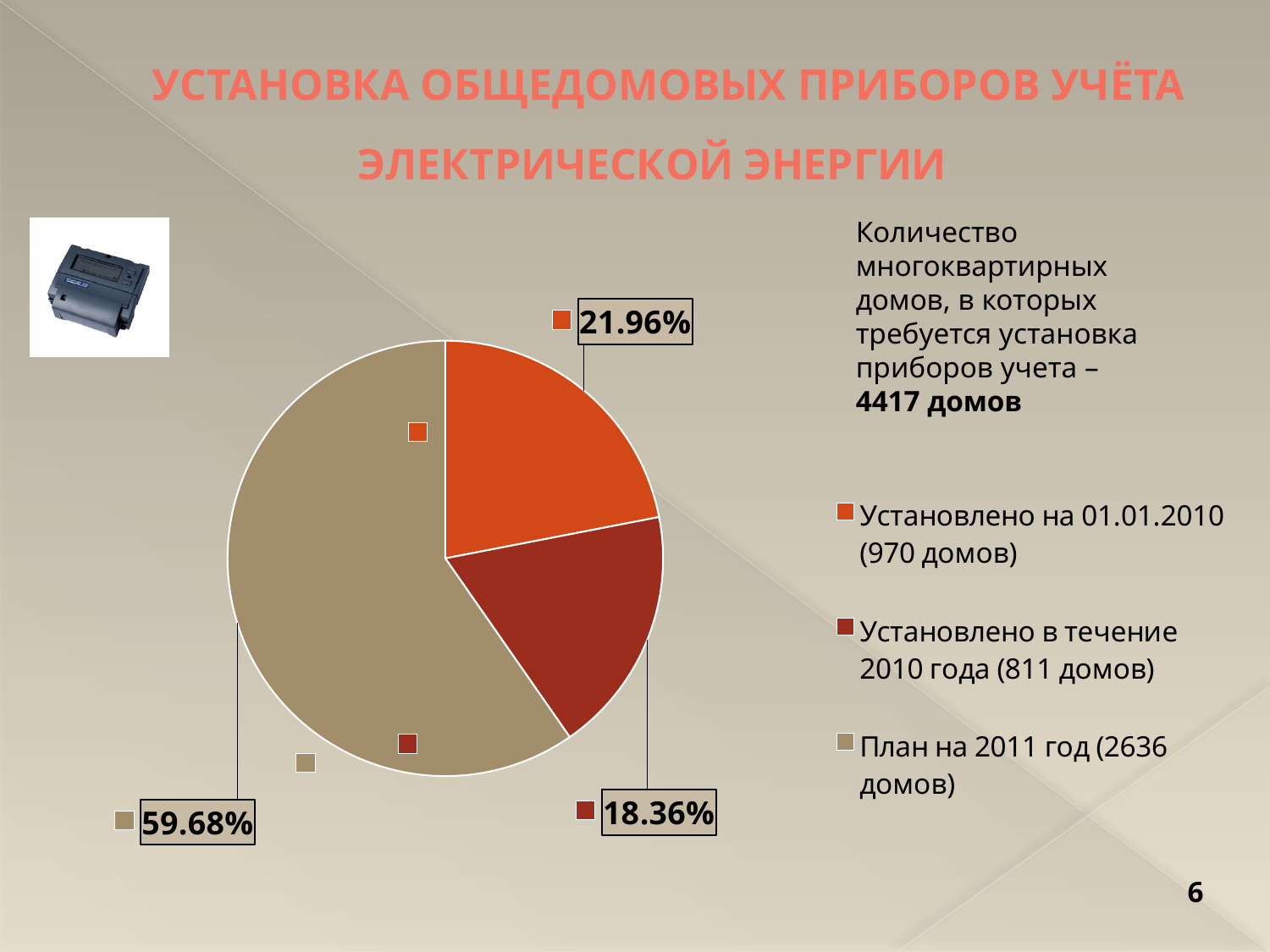
What percentage share does the slice 'Установлено на 01.01.2010' have in the pie chart? 21.96% What is the difference in percentage points between the 'План на 2011 год' slice and the 'Установлено на 01.01.2010' slice? 37.72 How many houses does the legend give for 'План на 2011 год'? 2636 домов Which slice of the pie chart is the smallest? Установлено в течение 2010 года Which slice of the pie chart is the largest? План на 2011 год What percentage share does the slice 'План на 2011 год' have in the pie chart? 59.68% Which is larger: the share for 'Установлено на 01.01.2010' or the share for 'Установлено в течение 2010 года'? Установлено на 01.01.2010 How many entries does the legend of the pie chart list? 3 What kind of chart is shown on the slide? pie chart How many slices does the pie chart have? 3 What percentage share does the slice 'Установлено в течение 2010 года' have in the pie chart? 18.36% How many houses does the legend give for 'Установлено на 01.01.2010'? 970 домов